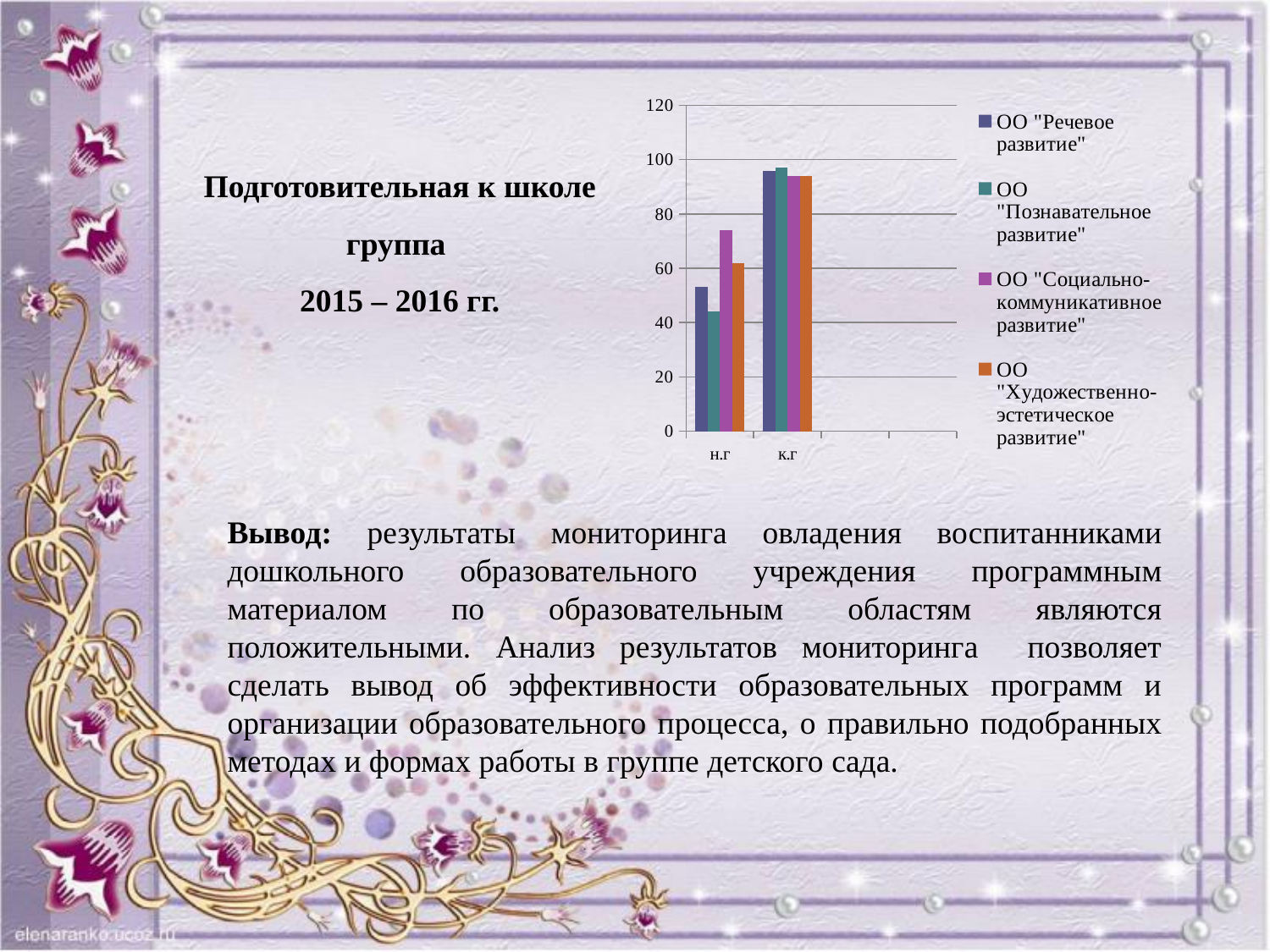
Which series has the lowest value for н.г? ОО "Познавательное развитие" For ОО "Речевое развитие", which is larger: the value for н.г or for к.г? к.г How many series does the chart legend list? 4 Is the value of ОО "Художественно-эстетическое развитие" for н.г greater or less than 80? less Which series has the highest value for н.г? ОО "Социально-коммуникативное развитие" How many categories are shown on the x axis of the chart? 2 What kind of chart is shown on the slide? bar chart Is the value of ОО "Социально-коммуникативное развитие" for н.г greater or less than 60? greater Is the value of ОО "Познавательное развитие" for н.г greater or less than 60? less What are the two category labels on the x axis of the chart? н.г and к.г Do the values for ОО "Познавательное развитие" rise or fall from н.г to к.г? rise